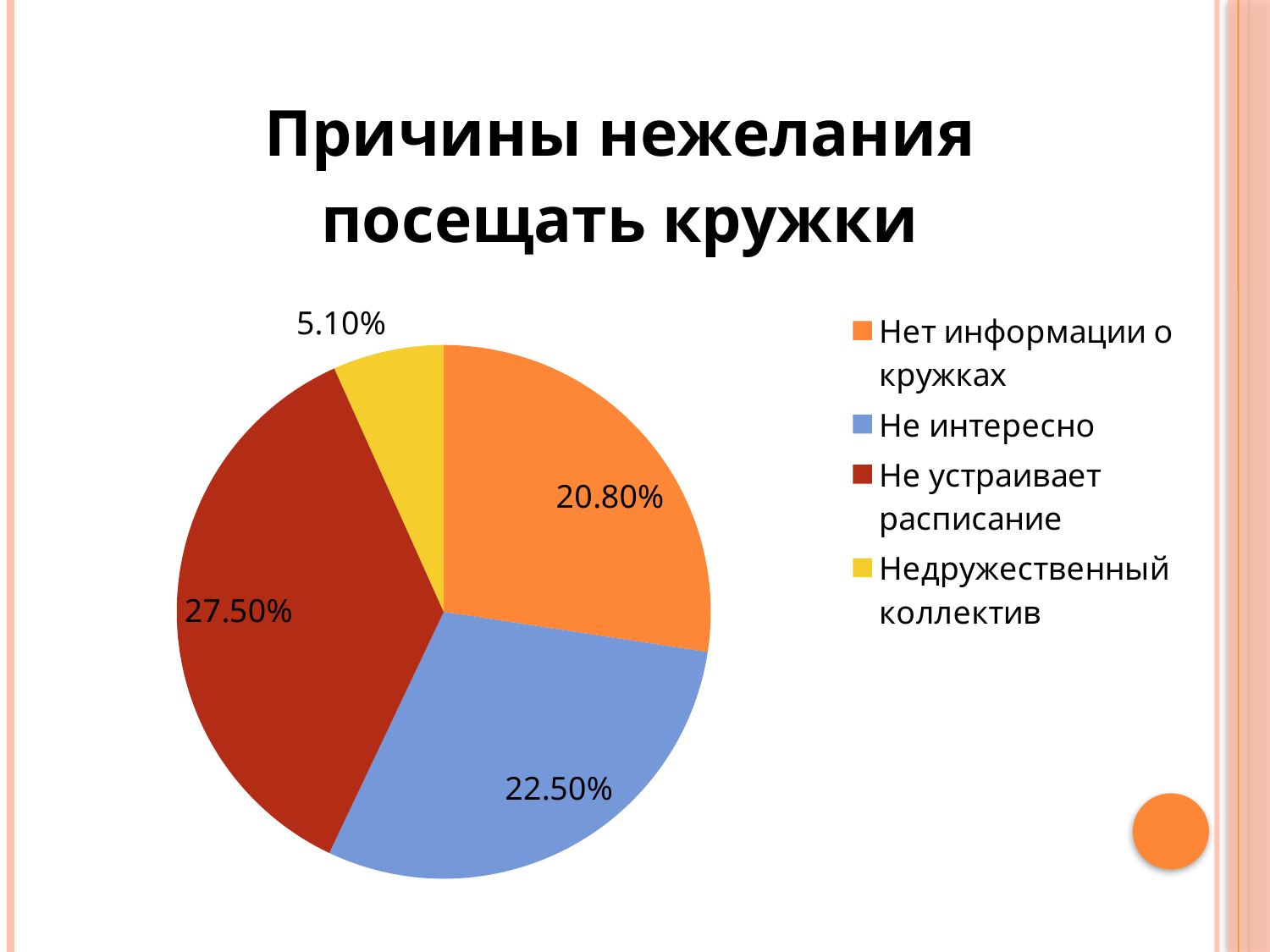
Which category has the largest slice of the pie? Не устраивает расписание What is the value shown for "Не интересно"? 22.50% How many categories does the pie chart have? 4 What is the value shown for "Не устраивает расписание"? 27.50% What is the difference between the values for "Не устраивает расписание" and "Не интересно"? 5.00% What kind of chart is shown on the slide? Pie chart What colour is the slice for "Недружественный коллектив"? Yellow What is the value shown for "Недружественный коллектив"? 5.10% What is the value shown for "Нет информации о кружках"? 20.80% Which is larger: the value for "Не интересно" or the value for "Нет информации о кружках"? Не интересно Which category has the smallest slice of the pie? Недружественный коллектив What is the title of the chart on the slide? Причины нежелания посещать кружки